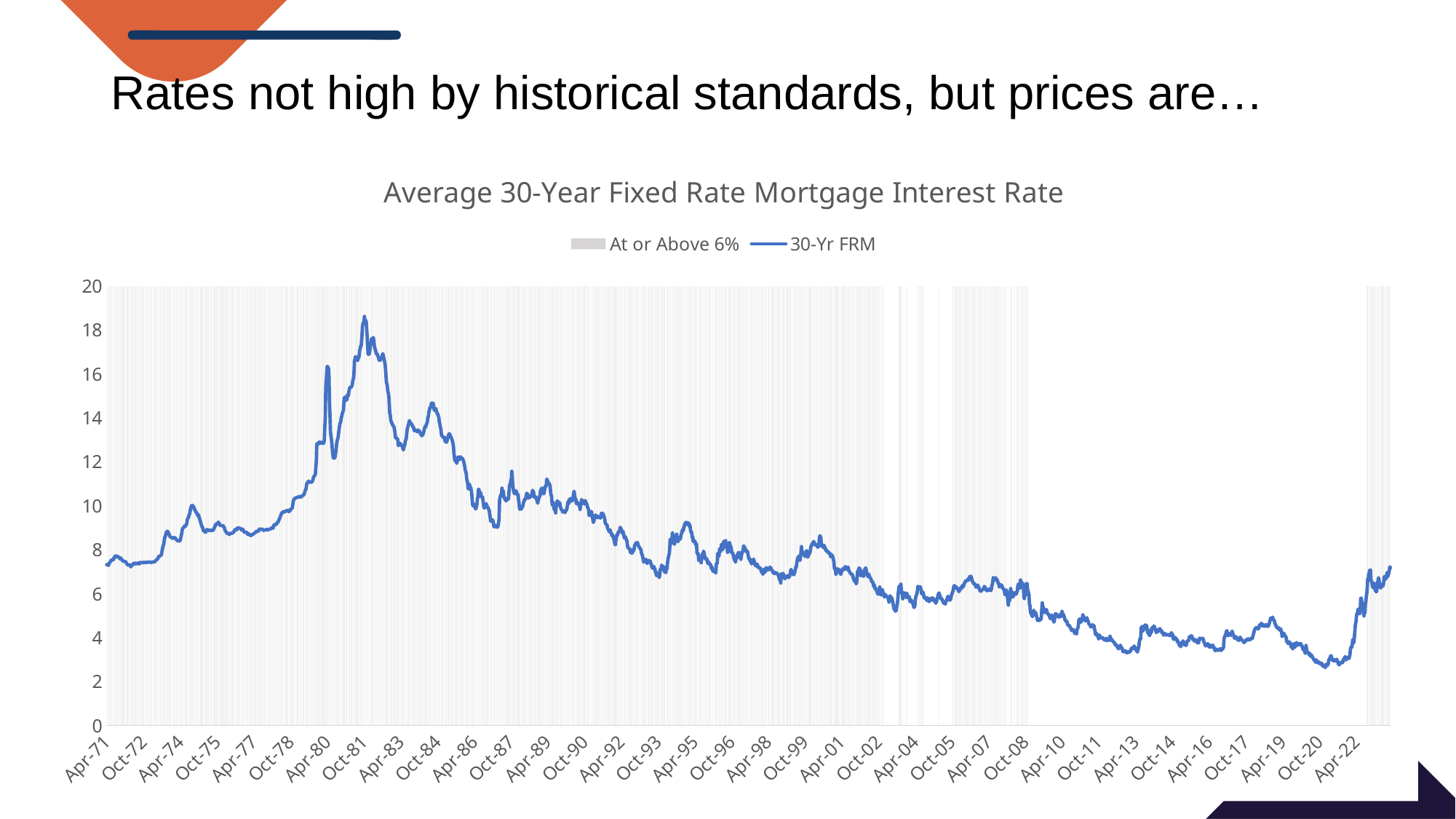
What are the two entries listed in the chart's legend? At or Above 6% and 30-Yr FRM How many entries does the chart's legend list? 2 What is the title of the chart? Average 30-Year Fixed Rate Mortgage Interest Rate What kind of chart is shown on the slide? line chart Around which x-axis label does the 30-Yr FRM line reach its lowest point? Oct-20 Does the 30-Yr FRM line generally rise or fall from Oct-81 to Oct-20? fall Is the 30-Yr FRM value near Apr-13 greater or less than 6? less Which is higher, the 30-Yr FRM value near Apr-80 or near Apr-16? Apr-80 Is the 30-Yr FRM value at its peak near Oct-81 greater or less than 16? greater Is the 30-Yr FRM value near Oct-20 greater or less than 4? less Around which x-axis label does the 30-Yr FRM line reach its highest point? Oct-81